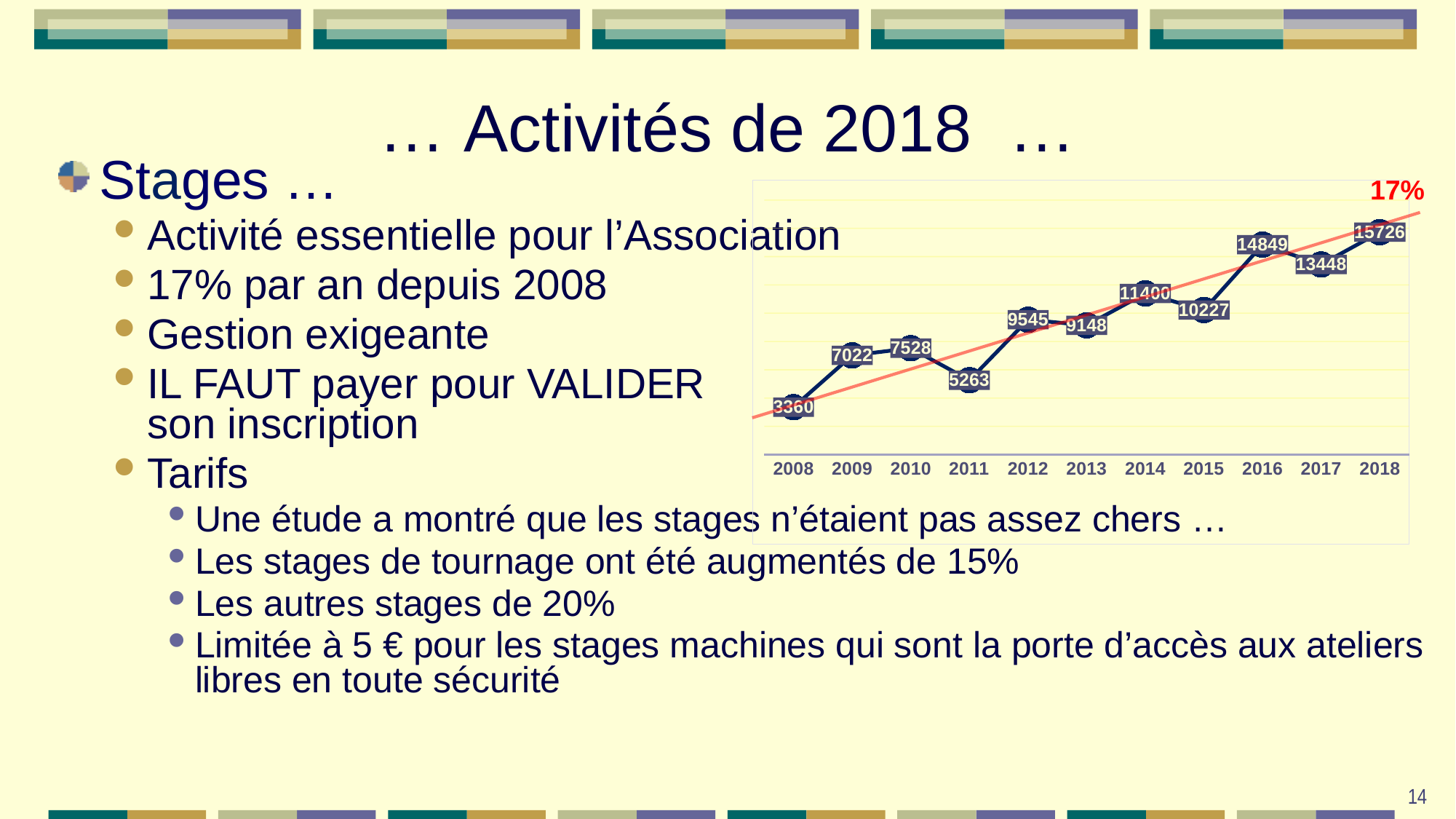
What is the difference between the values for 2018 and 2008? 12366 Which is larger, the value for 2012 or the value for 2013? 2012 What is the difference between the values for 2016 and 2017? 1401 How many years are plotted on the x axis? 11 What is the value for 2018? 15726 Which year has the highest value? 2018 Which year has the lowest value? 2008 What is the value for 2016? 14849 What is the value for 2008? 3360 What kind of chart is shown? line chart What is the value for 2011? 5263 What percentage is written next to the straight trend line on the chart? 17%